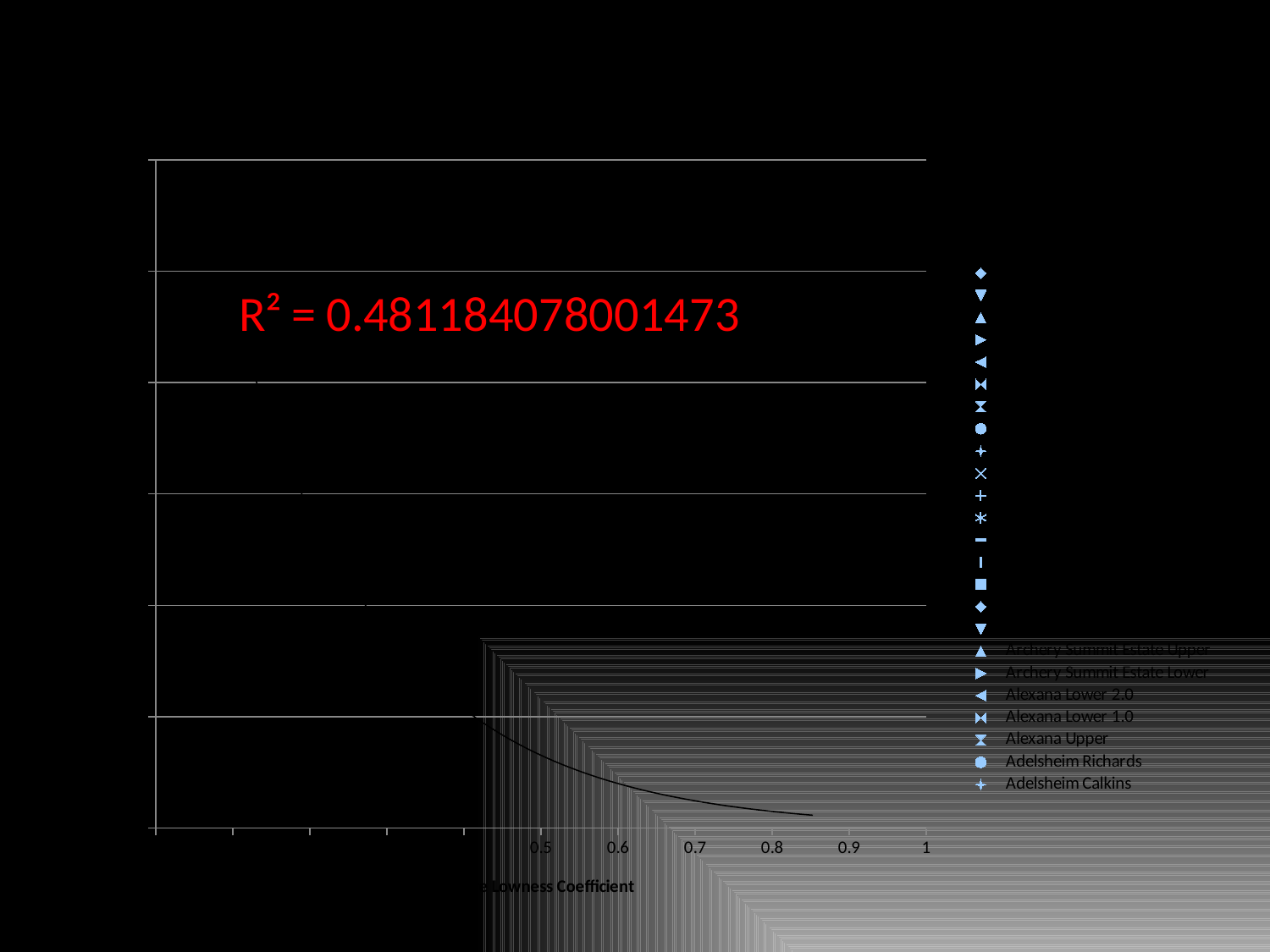
Does the fitted trendline on the chart rise or fall as the x-axis value increases? fall What kind of chart is shown on the slide? scatter chart Which legend entry is listed last (at the bottom) in the chart's legend? Adelsheim Calkins What R² value is printed on the chart? R² = 0.481184078001473